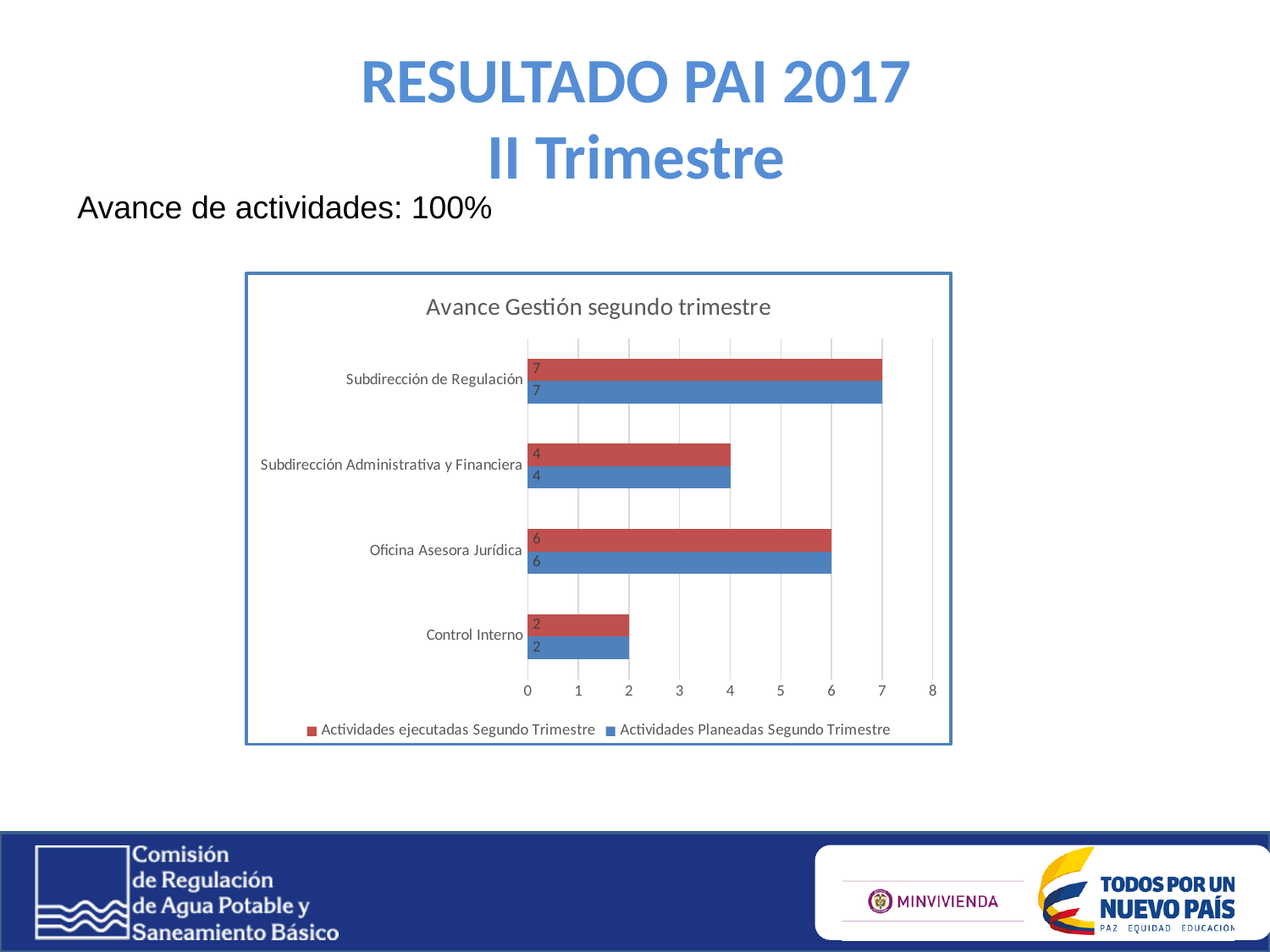
Which is larger: the Actividades Planeadas Segundo Trimestre value for Oficina Asesora Jurídica or for Subdirección Administrativa y Financiera? Oficina Asesora Jurídica What is the value of Actividades Planeadas Segundo Trimestre for Oficina Asesora Jurídica? 6 What is the value of Actividades Planeadas Segundo Trimestre for Control Interno? 2 How many categories are shown on the chart? 4 What is the difference between the Actividades ejecutadas Segundo Trimestre values for Subdirección de Regulación and Subdirección Administrativa y Financiera? 3 What type of chart is shown on the slide? bar chart What is the title of the chart? Avance Gestión segundo trimestre How many series does the legend list? 2 Which category has the highest value for Actividades Planeadas Segundo Trimestre? Subdirección de Regulación Which colour represents Actividades Planeadas Segundo Trimestre in the legend? blue What is the value of Actividades ejecutadas Segundo Trimestre for Subdirección de Regulación? 7 Which category has the lowest value for Actividades ejecutadas Segundo Trimestre? Control Interno